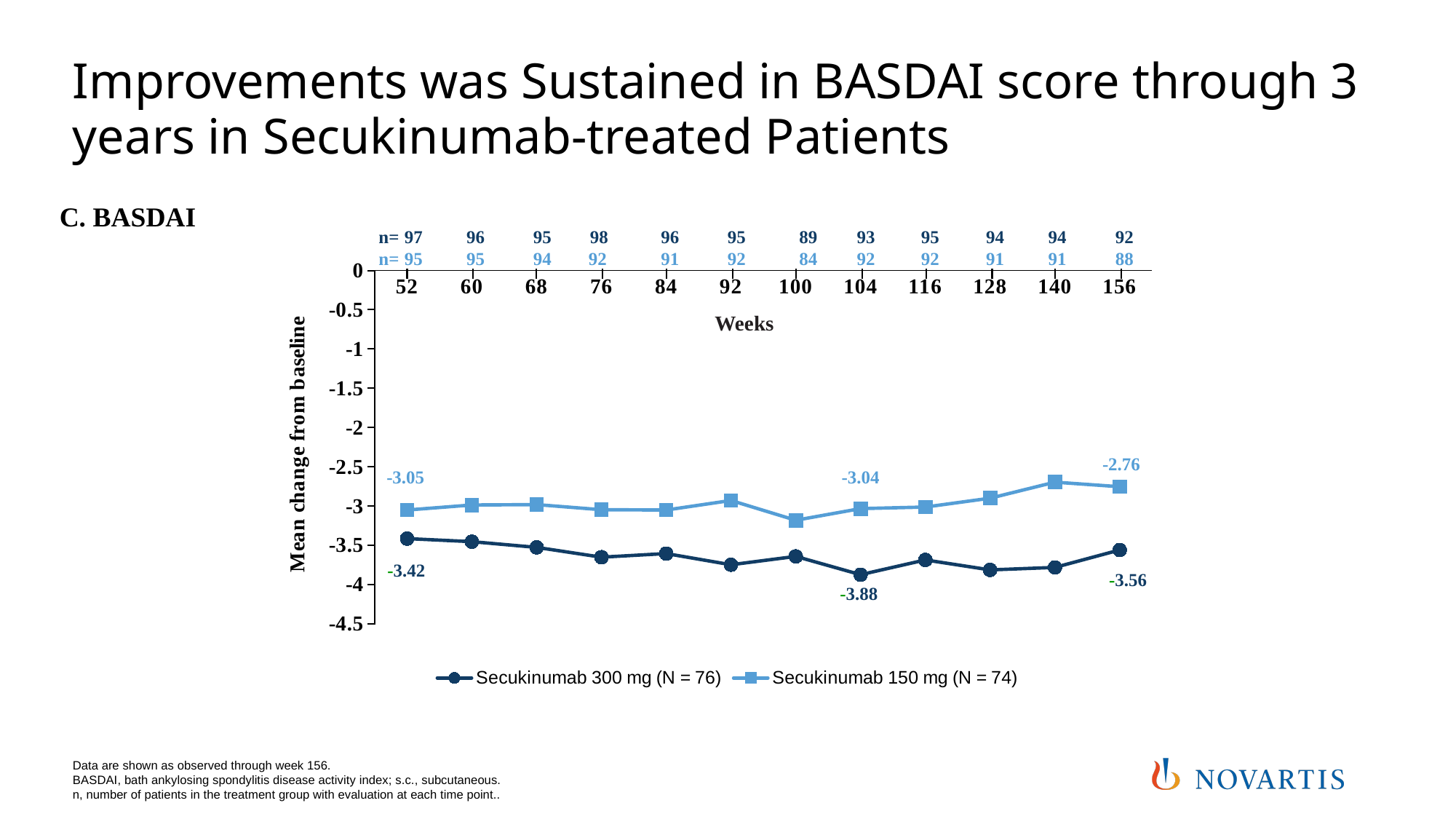
What is the mean change from baseline for Secukinumab 150 mg at week 156? -2.76 What is the mean change from baseline for Secukinumab 150 mg at week 104? -3.04 How many week time points are plotted on the x axis? 12 What kind of chart is shown on the slide? line chart At which week does the Secukinumab 150 mg series reach its lowest mean change from baseline? 100 Which series has the larger (less negative) mean change from baseline at week 52, Secukinumab 300 mg or Secukinumab 150 mg? Secukinumab 150 mg What is the mean change from baseline for Secukinumab 300 mg at week 104? -3.88 What is the difference between the Secukinumab 300 mg and Secukinumab 150 mg values at week 156? 0.80 What is the mean change from baseline for Secukinumab 300 mg at week 52? -3.42 How many series does the legend list? 2 At which week does the Secukinumab 300 mg series reach its lowest mean change from baseline? 104 Is the value for Secukinumab 300 mg at week 128 greater or less than -3.5? less